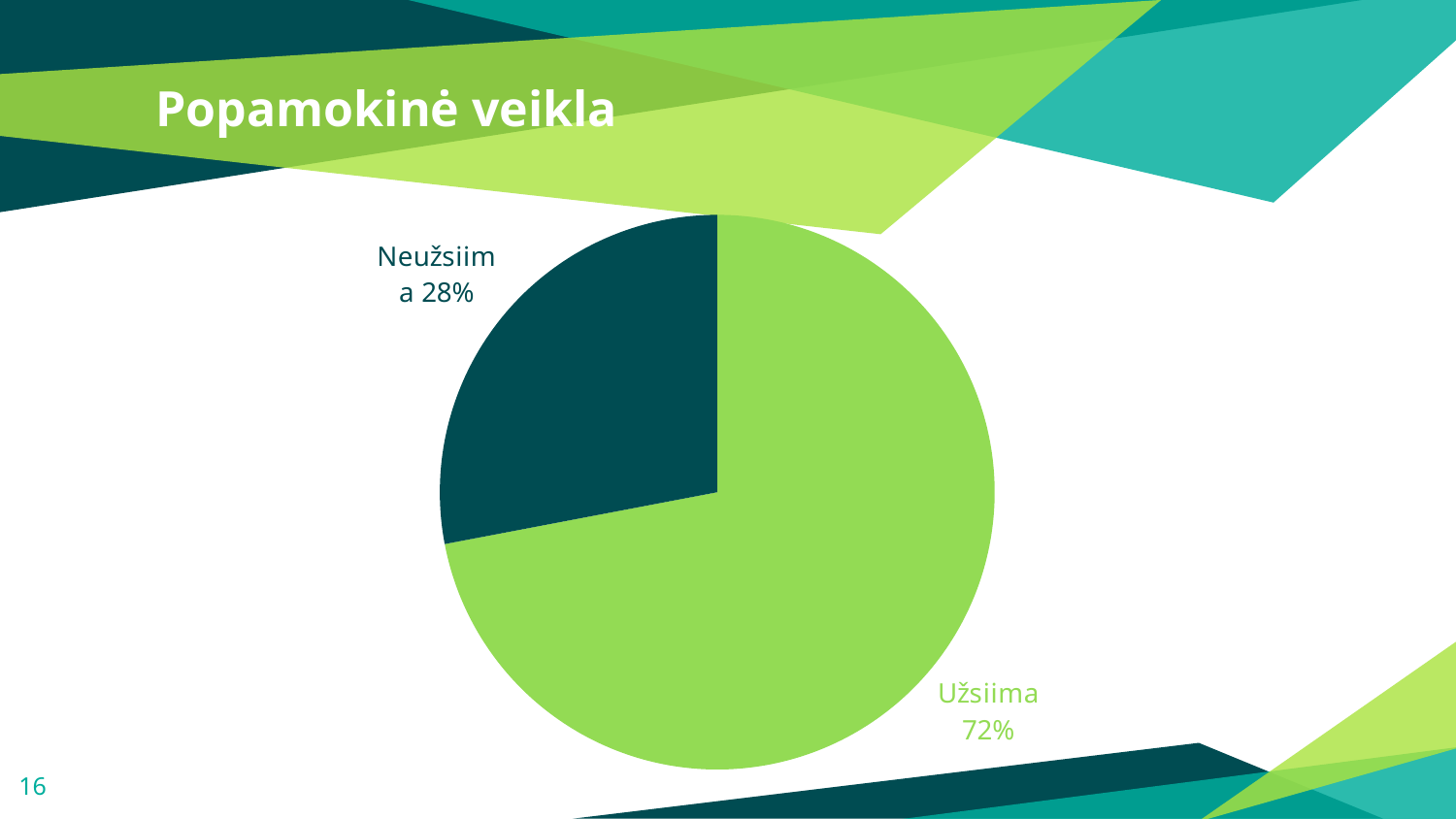
Which slice of the pie is the largest? Užsiima How many slices does the pie chart have? 2 Is the share for Užsiima greater or less than 50%? greater What share of the pie does the Užsiima slice represent? 72% What is the title of the slide containing the pie chart? Popamokinė veikla Which is larger, the Užsiima slice or the Neužsiima slice? Užsiima What share of the pie does the Neužsiima slice represent? 28% What kind of chart is shown on the slide? pie chart What colour is the Neužsiima slice of the pie? dark teal What is the difference in percentage points between the Užsiima and Neužsiima slices? 44 Which slice of the pie is the smallest? Neužsiima